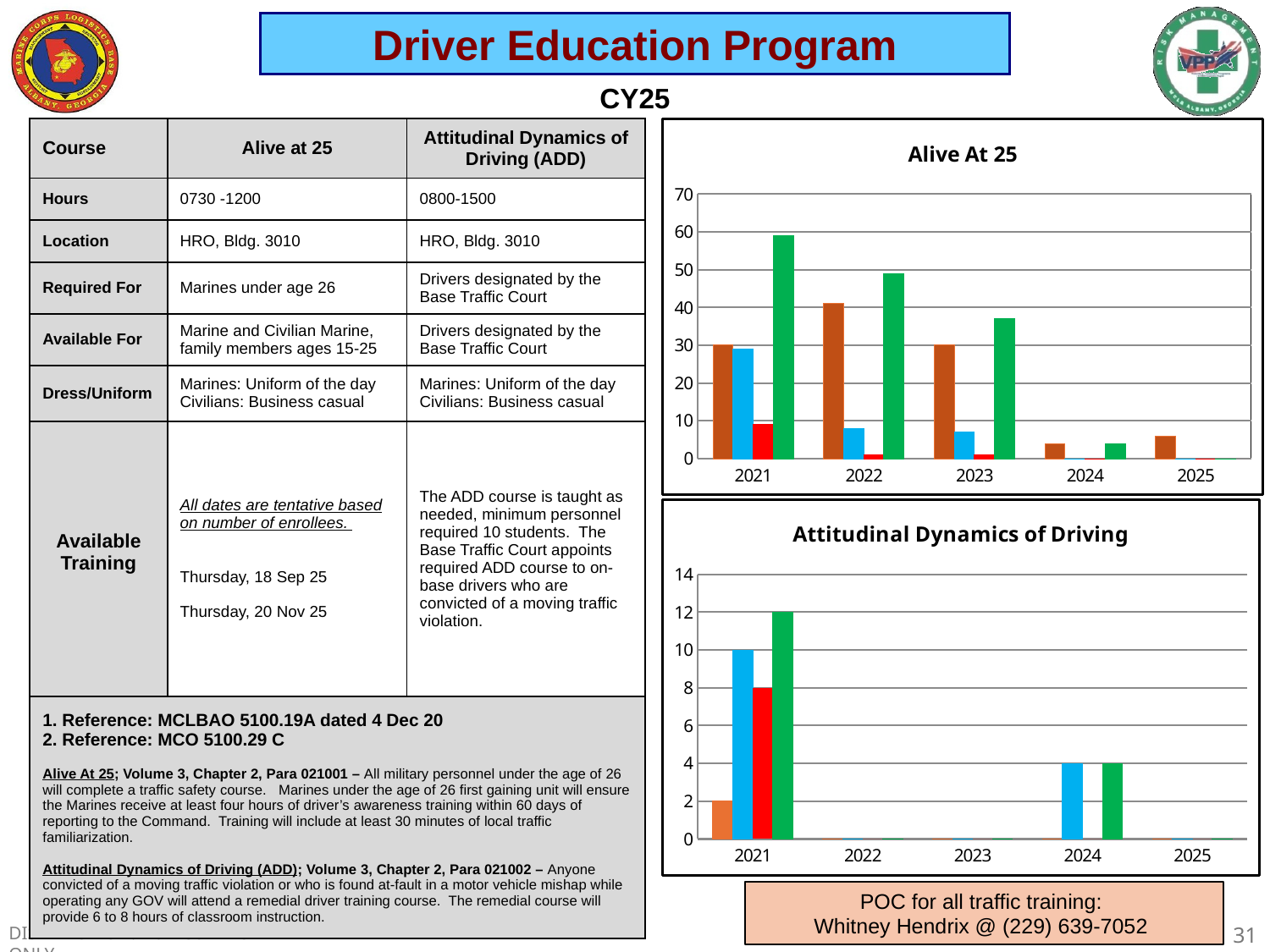
In the "Attitudinal Dynamics of Driving" chart, what is the value of the green bar for 2021? 12 In the "Attitudinal Dynamics of Driving" chart, what is the value of the blue bar for 2024? 4 What kind of chart is the "Alive At 25" chart? bar chart How many years are shown on the x axis of the "Alive At 25" chart? 5 In the "Attitudinal Dynamics of Driving" chart, which year has the tallest bar? 2021 In the "Attitudinal Dynamics of Driving" chart, what is the value of the blue bar for 2021? 10 In the "Alive At 25" chart, is the blue bar for 2023 greater or less than 10? less In the "Alive At 25" chart, is the green bar for 2021 greater or less than 50? greater In the "Alive At 25" chart, do the green bars rise or fall from 2021 to 2025? fall In the "Alive At 25" chart, which year has the tallest bar overall? 2021 In the "Attitudinal Dynamics of Driving" chart, what is the difference between the green bar and the red bar for 2021? 4